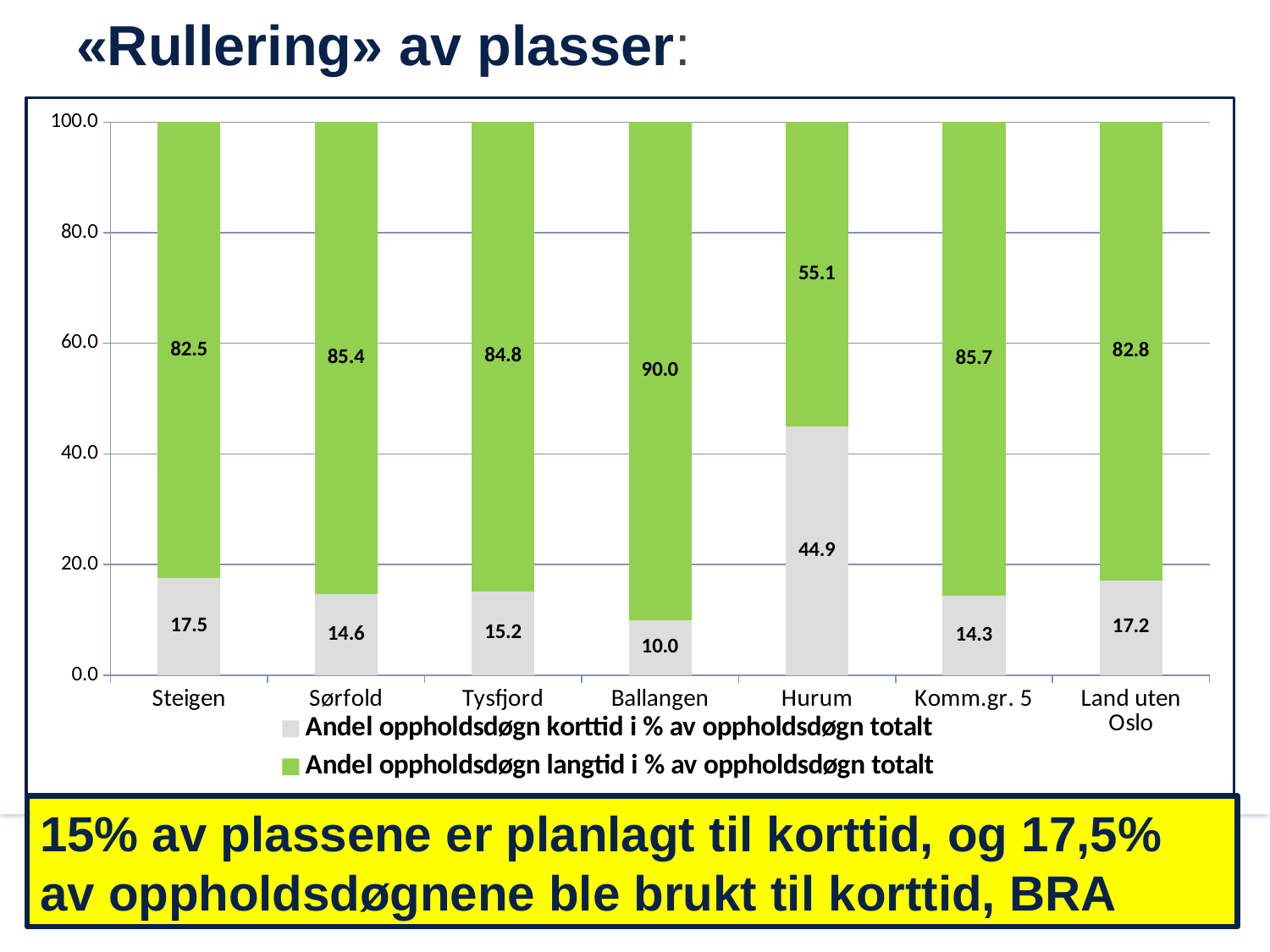
What is the value of 'Andel oppholdsdøgn korttid i % av oppholdsdøgn totalt' for Hurum? 44.9 Which category has the lowest value for 'Andel oppholdsdøgn korttid i % av oppholdsdøgn totalt'? Ballangen Which category has the highest value for 'Andel oppholdsdøgn korttid i % av oppholdsdøgn totalt'? Hurum How many categories are shown on the x axis? 7 What is the total of the stacked bar for Tysfjord? 100.0 What is the value of 'Andel oppholdsdøgn langtid i % av oppholdsdøgn totalt' for Ballangen? 90.0 What kind of chart is shown on the slide? Stacked bar chart Which is larger, the 'langtid' value for Sørfold or for Komm.gr. 5? Komm.gr. 5 How many series does the legend list? 2 What is the difference between the 'korttid' values for Steigen and Sørfold? 2.9 Which category has the lowest value for 'Andel oppholdsdøgn langtid i % av oppholdsdøgn totalt'? Hurum What is the value of 'Andel oppholdsdøgn korttid i % av oppholdsdøgn totalt' for Steigen? 17.5